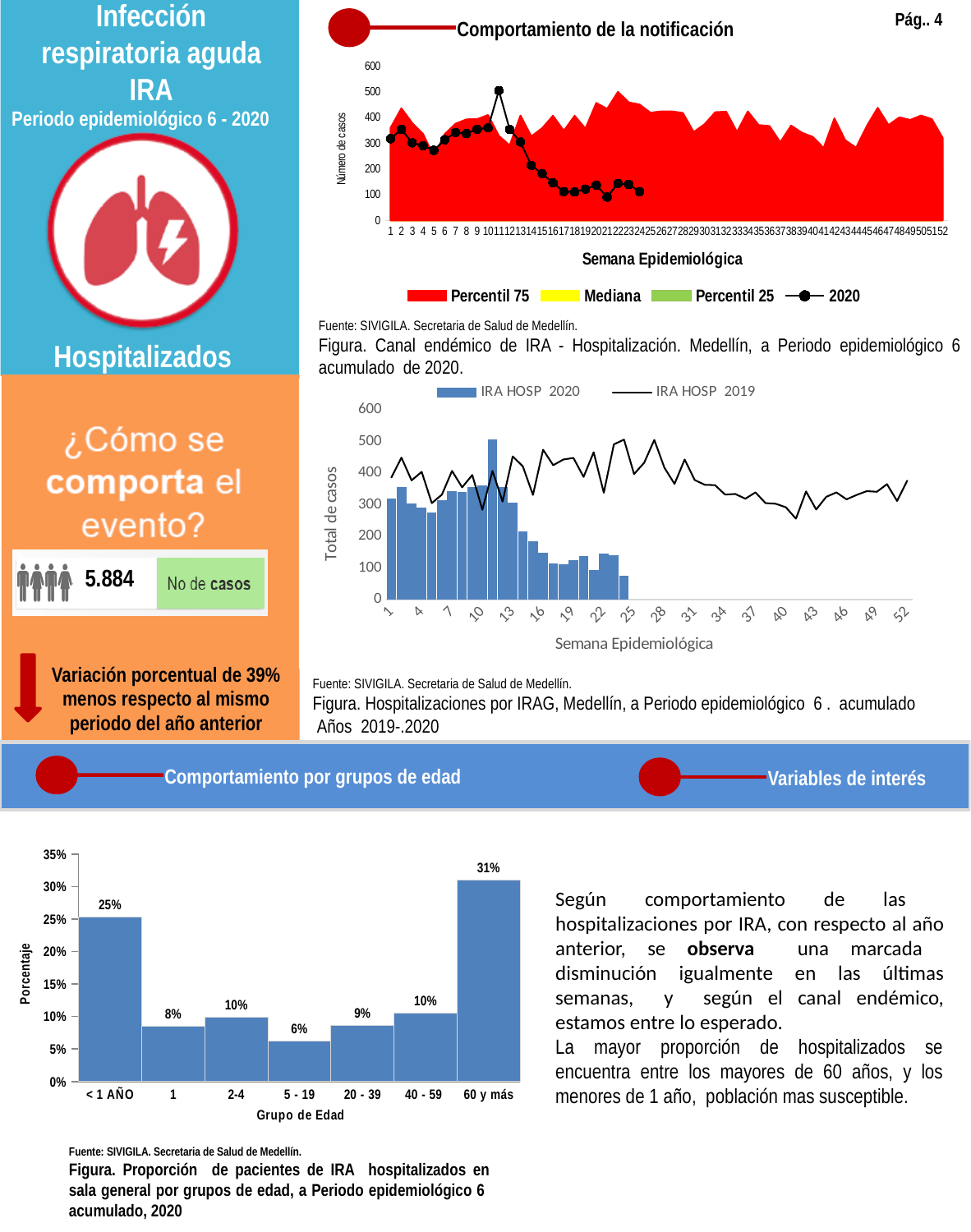
In the top chart (Canal endémico), is the 2020 value at week 11 greater or less than 400? greater What kind of chart is the 'Comportamiento por grupos de edad' chart at the bottom of the slide? bar chart How many series does the legend of the middle chart (Hospitalizaciones por IRAG, 2019-2020) list? 2 In the age-group bar chart at the bottom, which age group has the lowest percentage? 5 - 19 In the age-group bar chart at the bottom, which is larger: the value for '20 - 39' or the value for '1'? 20 - 39 In the middle chart (Hospitalizaciones por IRAG), is the IRA HOSP 2020 value at week 24 greater or less than 100? less In the age-group bar chart at the bottom, what is the difference in percentage points between the '60 y más' group and the '< 1 AÑO' group? 6 How many series does the legend of the top chart (Canal endémico de IRA - Hospitalización) list? 4 In the age-group bar chart at the bottom, which age group has the highest percentage? 60 y más In the age-group bar chart at the bottom, what percentage is shown for the '< 1 AÑO' group? 25% In the age-group bar chart at the bottom, what percentage is shown for the '60 y más' group? 31% How many age groups are shown in the bar chart at the bottom of the slide? 7